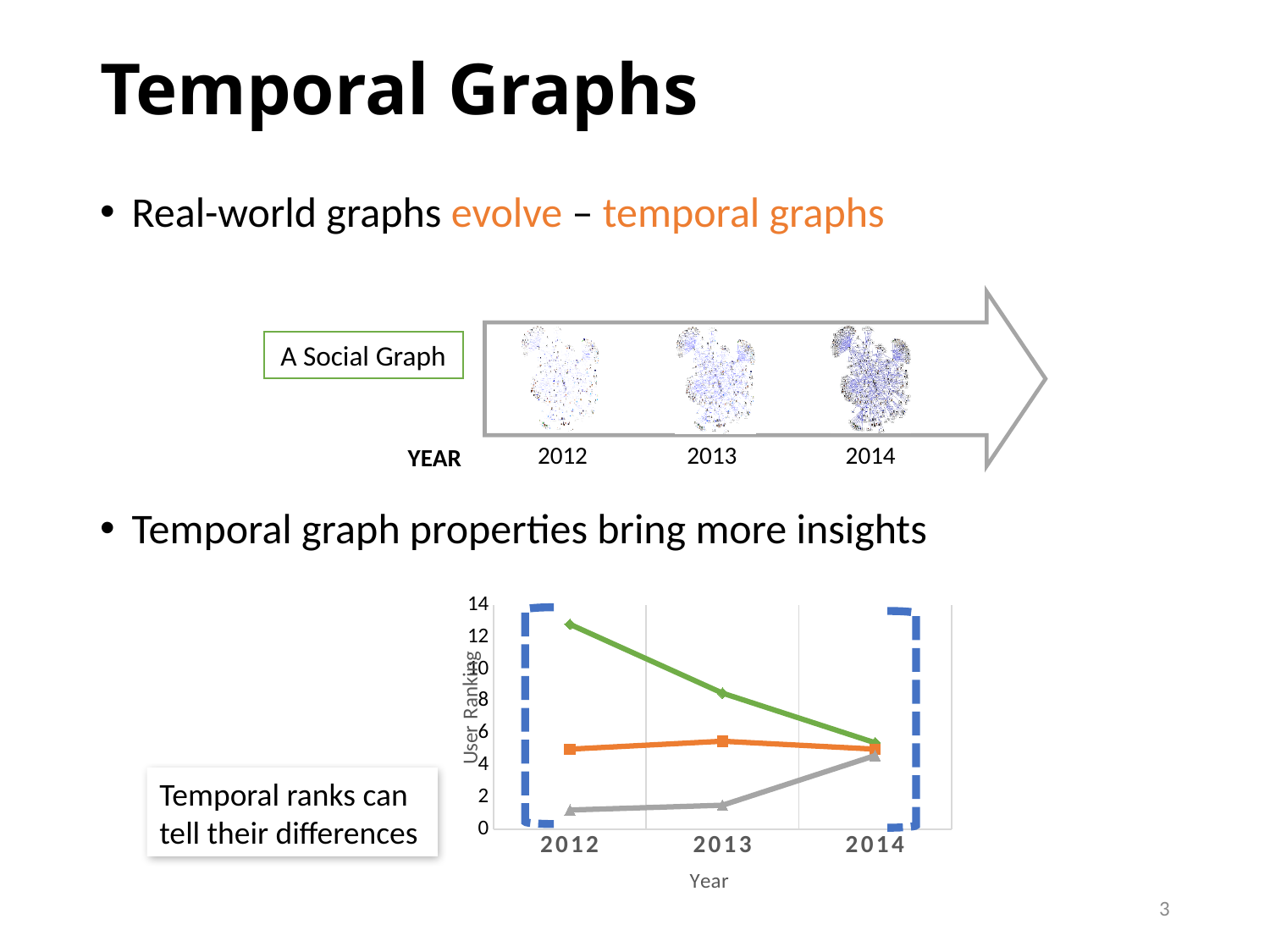
Is the value of the green line in 2012 greater or less than 12? greater Is the value of the orange line in 2013 greater or less than 6? less In which year does the green line reach its highest value? 2012 How many years are shown on the x axis of the line chart? 3 What is the label of the x axis of the line chart? Year What is the label of the y axis of the line chart? User Ranking What kind of chart is shown at the bottom of the slide? line chart How many lines are plotted in the line chart? 3 Is the value of the gray line in 2012 greater or less than 2? less Does the green line rise or fall from 2012 to 2014? fall In 2012, which line has the larger value, the green line or the gray line? green line Does the gray line rise or fall from 2012 to 2014? rise